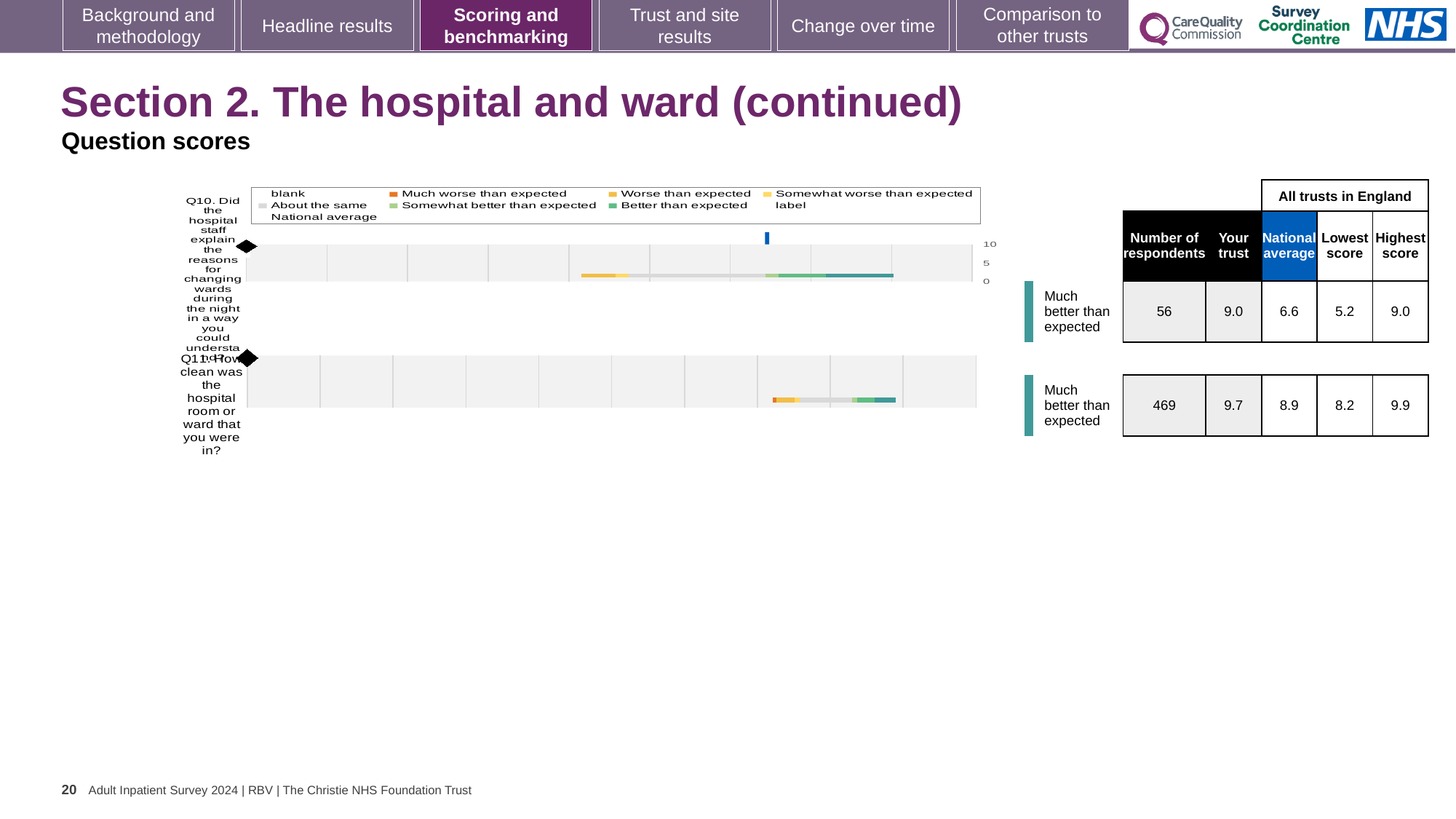
By how much does the trust's score for Q10 exceed the national average for Q10? 2.4 What is the highest score among all trusts in England for Q11? 9.9 How many respondents answered Q11? 469 What is the 'Your trust' score for Q10 (Did the hospital staff explain the reasons for changing wards during the night)? 9.0 What is the lowest score among all trusts in England for Q10? 5.2 By how much does the trust's score for Q11 exceed the national average for Q11? 0.8 What is the national average score for Q10? 6.6 What kind of chart is used to show the question scores? Bar chart What is the 'Your trust' score for Q11 (How clean was the hospital room or ward that you were in?)? 9.7 How many questions are plotted on this slide? 2 Which question has the higher 'Your trust' score, Q10 or Q11? Q11 What benchmark category is shown next to both Q10 and Q11? Much better than expected